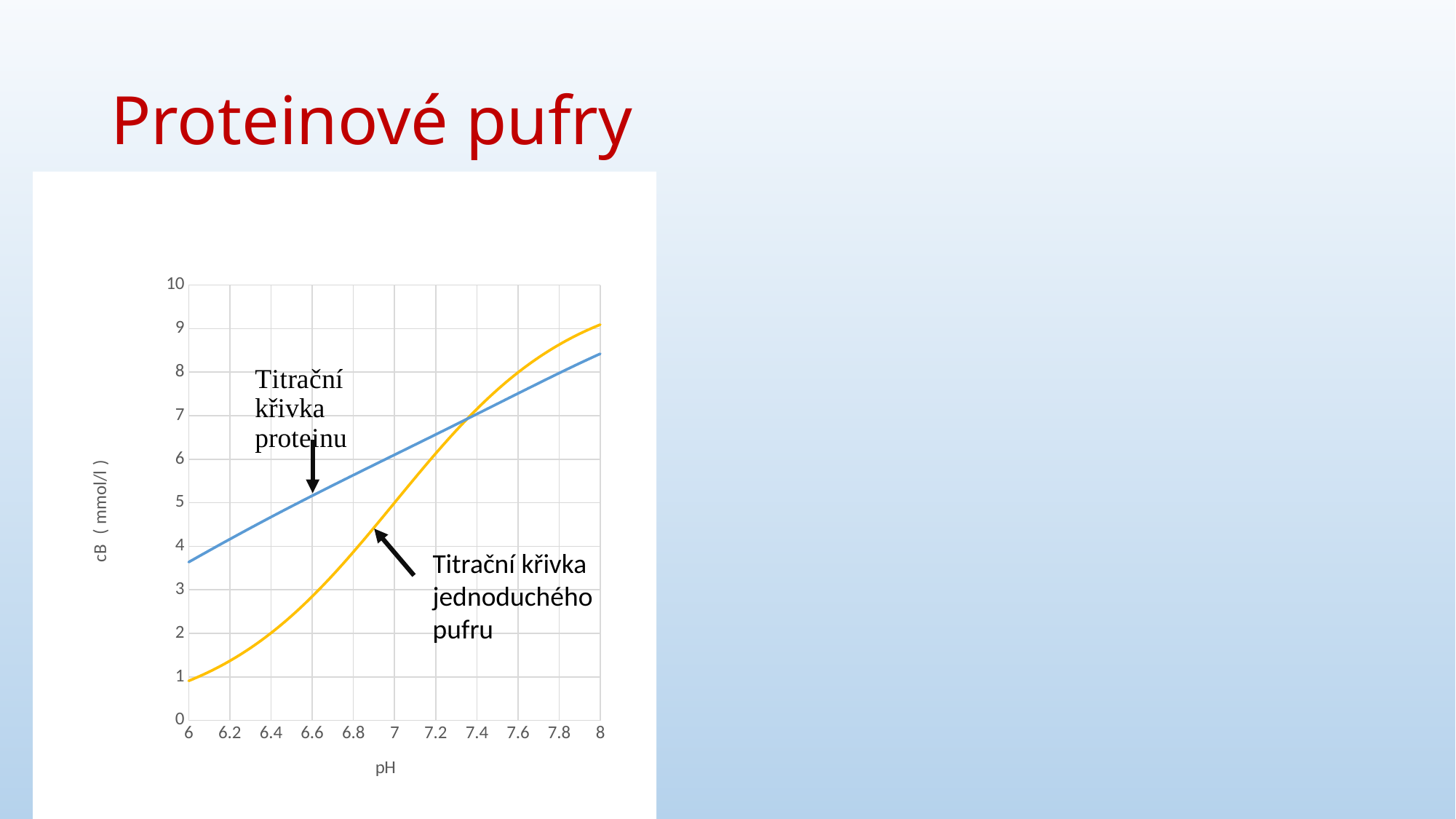
At pH 6, is the value of the 'Titrační křivka proteinu' curve greater or less than 3? greater What kind of chart is shown on the slide? line chart At pH 8, is the value of the 'Titrační křivka jednoduchého pufru' curve greater or less than 8? greater What is the label of the x axis? pH How many curves are plotted on the chart? 2 What is the label of the y axis? cB ( mmol/l ) At pH 7, is the value of the 'Titrační křivka proteinu' curve greater or less than 5? greater Does the curve labelled 'Titrační křivka jednoduchého pufru' rise or fall as pH increases from 6 to 8? rise Does the curve labelled 'Titrační křivka proteinu' rise or fall as pH increases from 6 to 8? rise At pH 8, which curve has the higher value, 'Titrační křivka proteinu' or 'Titrační křivka jednoduchého pufru'? Titrační křivka jednoduchého pufru At pH 6, which curve has the higher value, 'Titrační křivka proteinu' or 'Titrační křivka jednoduchého pufru'? Titrační křivka proteinu